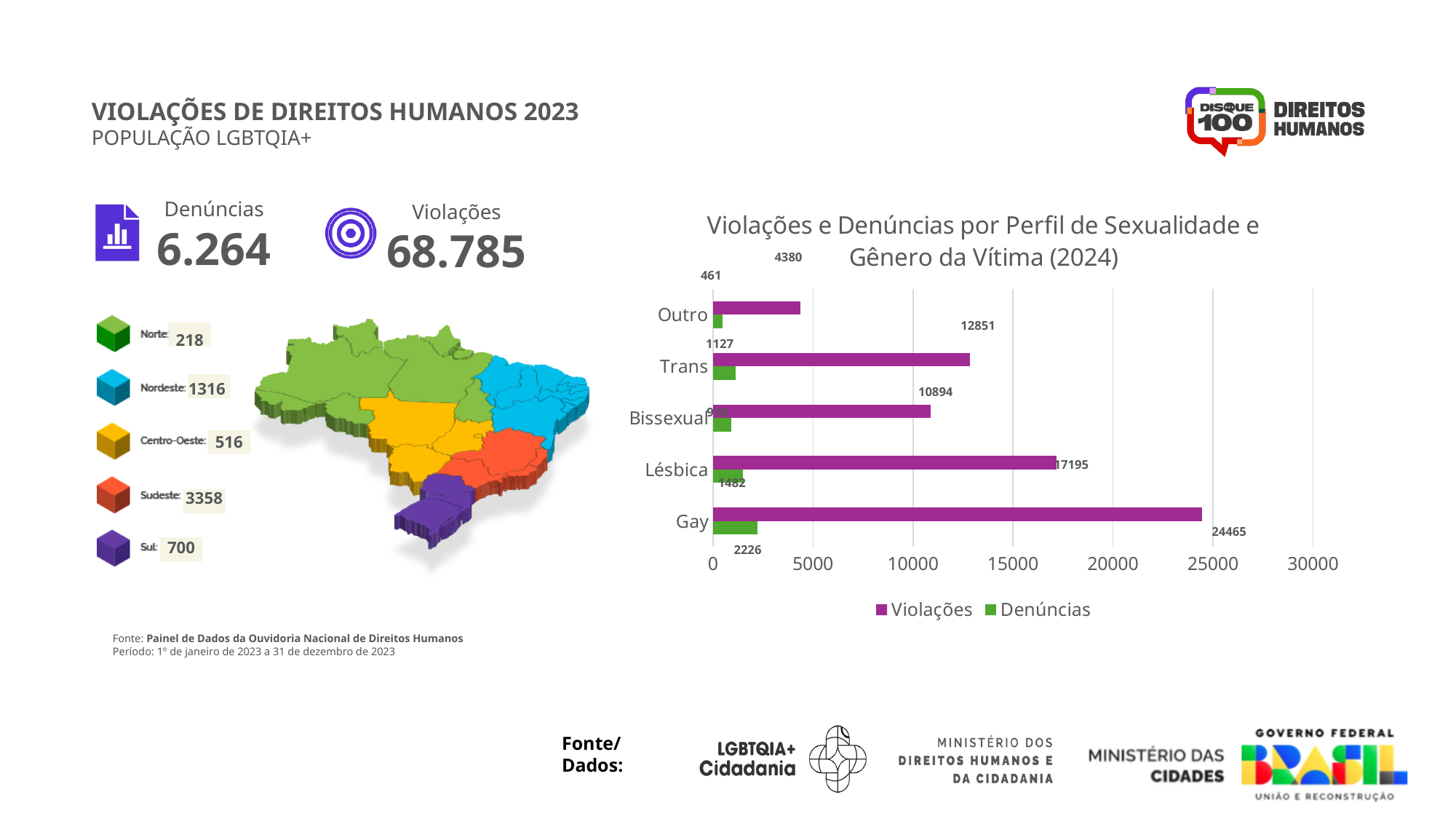
In the chart 'Violações e Denúncias por Perfil de Sexualidade e Gênero da Vítima (2024)', what is the Denúncias value for Trans? 1127 In the chart 'Violações e Denúncias por Perfil de Sexualidade e Gênero da Vítima (2024)', which category has the highest Violações value? Gay In the chart 'Violações e Denúncias por Perfil de Sexualidade e Gênero da Vítima (2024)', which has a larger Violações value, Trans or Bissexual? Trans In the chart 'Violações e Denúncias por Perfil de Sexualidade e Gênero da Vítima (2024)', what is the Violações value for Gay? 24465 In the chart 'Violações e Denúncias por Perfil de Sexualidade e Gênero da Vítima (2024)', which category has the lowest Denúncias value? Outro In the chart 'Violações e Denúncias por Perfil de Sexualidade e Gênero da Vítima (2024)', what colour represents the Violações series? purple In the chart 'Violações e Denúncias por Perfil de Sexualidade e Gênero da Vítima (2024)', what is the Violações value for Outro? 4380 In the chart 'Violações e Denúncias por Perfil de Sexualidade e Gênero da Vítima (2024)', what is the difference between the Violações values for Gay and Lésbica? 7270 How many series does the legend of the chart 'Violações e Denúncias por Perfil de Sexualidade e Gênero da Vítima (2024)' list? 2 In the chart 'Violações e Denúncias por Perfil de Sexualidade e Gênero da Vítima (2024)', is the Violações value for Lésbica greater or less than 15000? greater How many categories are shown in the chart 'Violações e Denúncias por Perfil de Sexualidade e Gênero da Vítima (2024)'? 5 What kind of chart is 'Violações e Denúncias por Perfil de Sexualidade e Gênero da Vítima (2024)'? bar chart